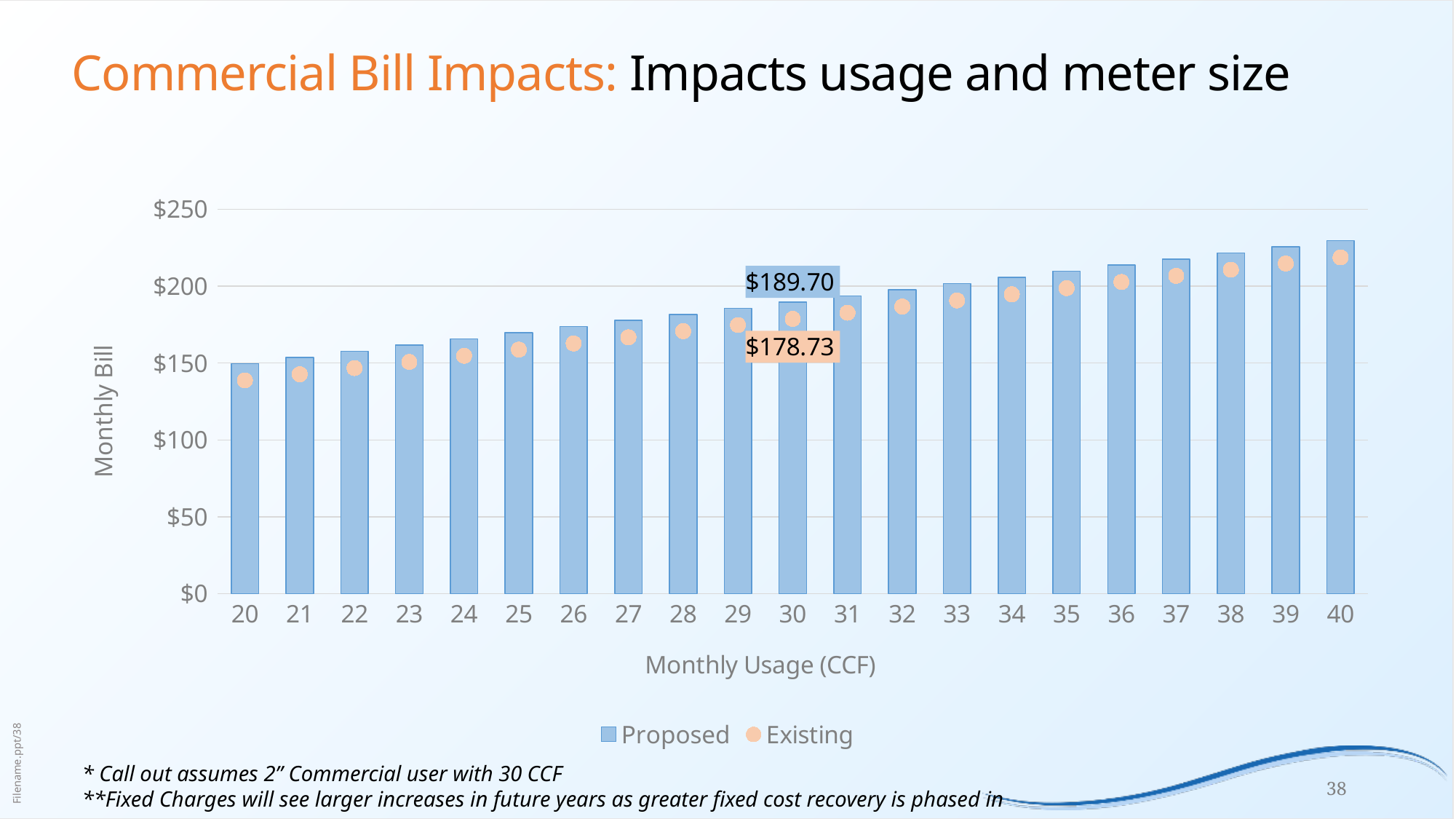
What kind of chart is used to show the Proposed monthly bill? Bar chart At which monthly usage level is the Proposed monthly bill highest? 40 What is the Proposed monthly bill at 30 CCF of monthly usage? $189.70 How many monthly usage levels are shown on the x axis? 21 What is the difference between the Proposed and Existing monthly bills at 30 CCF? $10.97 Is the Proposed monthly bill at 40 CCF greater or less than $200? greater At 30 CCF, which is larger, the Proposed bill or the Existing bill? Proposed How many series does the legend list? 2 What is the Existing monthly bill at 30 CCF of monthly usage? $178.73 Do the Proposed monthly bills rise or fall as monthly usage increases from 20 to 40 CCF? Rise At which monthly usage level is the Proposed monthly bill lowest? 20 Is the Existing monthly bill at 20 CCF greater or less than $150? less